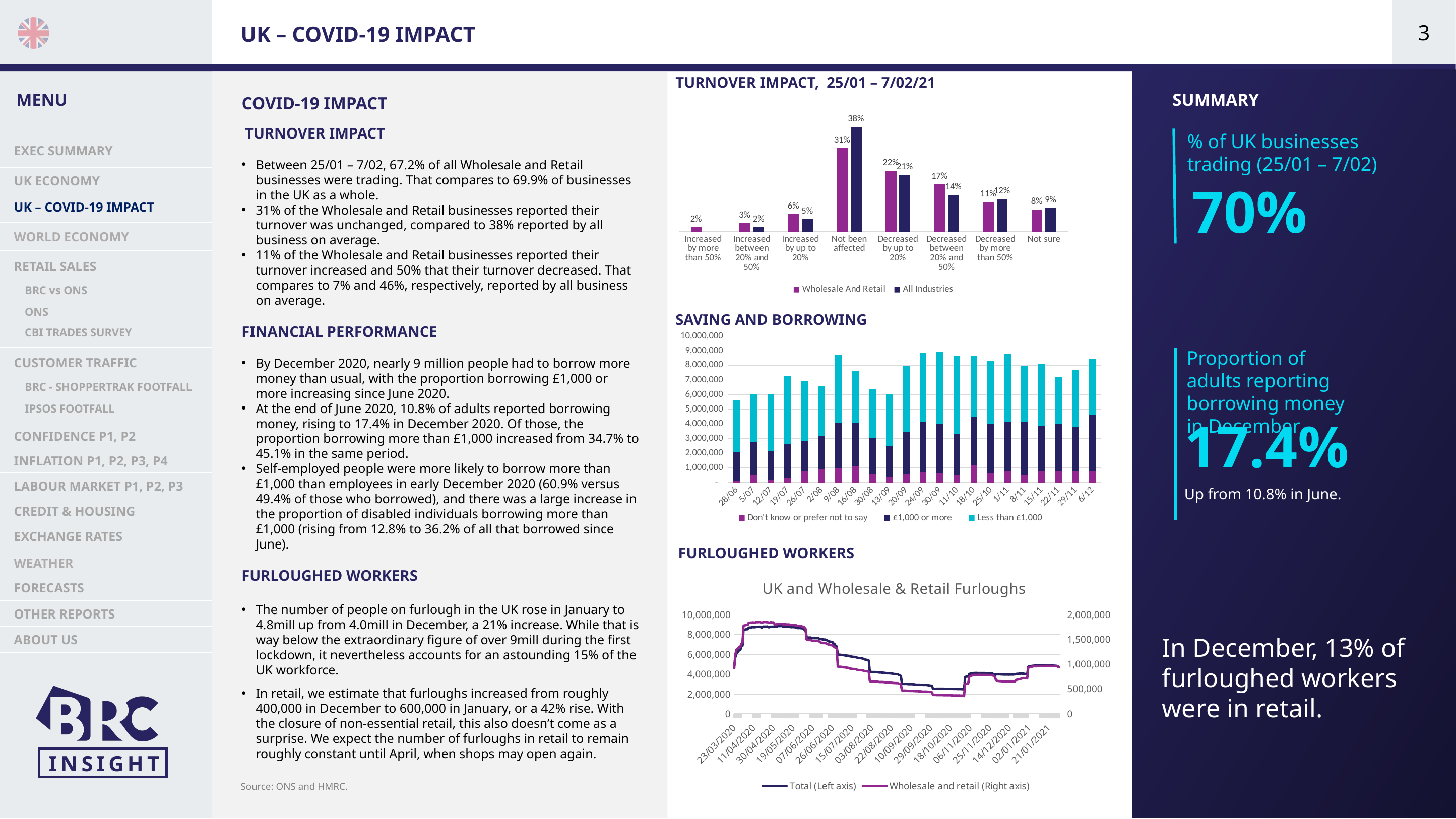
In the Saving and Borrowing chart, is the total stacked value for 30/09 greater or less than 8,000,000? greater In the Turnover Impact chart, what is the All Industries value for 'Not been affected'? 38% In the Turnover Impact chart, what percentage of Wholesale and Retail businesses reported they had not been affected? 31% In the Turnover Impact chart, what is the Wholesale And Retail value for 'Not sure'? 8% What type of chart is the Saving and Borrowing chart? Stacked bar chart In the Turnover Impact chart, which is larger for 'Decreased between 20% and 50%': Wholesale And Retail or All Industries? Wholesale And Retail In the Saving and Borrowing chart, is the total stacked value for 28/06 greater or less than 6,000,000? less How many categories are shown on the x axis of the Turnover Impact chart? 8 What type of chart is 'UK and Wholesale & Retail Furloughs'? Line chart In the Turnover Impact chart, which category has the highest value for All Industries? Not been affected In the Turnover Impact chart, what is the difference between the All Industries and Wholesale And Retail values for 'Not been affected'? 7% How many series does the legend of the Saving and Borrowing chart list? 3